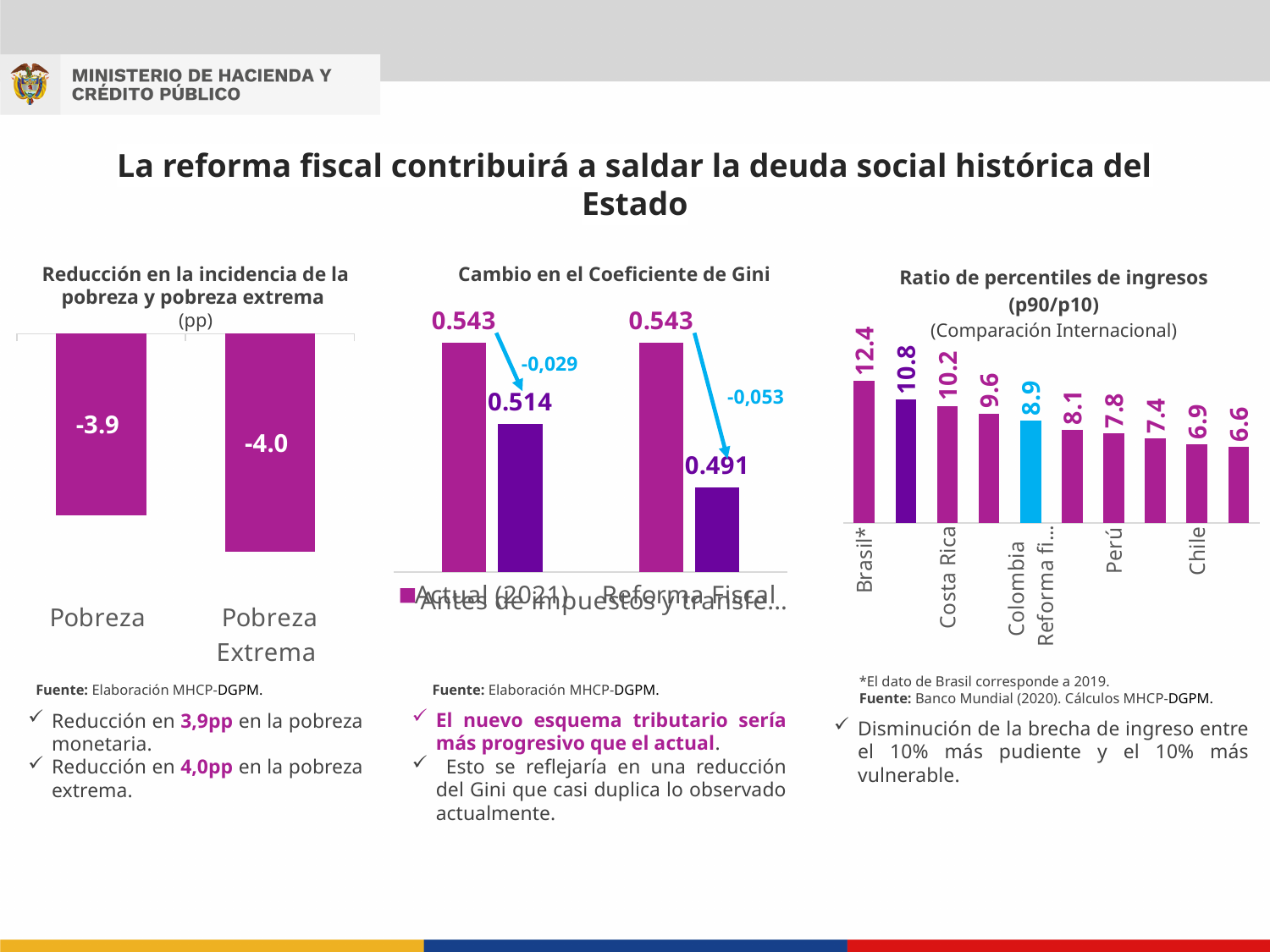
In the chart 'Cambio en el Coeficiente de Gini', what is the lower Gini value shown for Reforma Fiscal? 0.491 In the chart 'Ratio de percentiles de ingresos (p90/p10)', which labelled country has the highest value? Brasil* In the chart 'Reducción en la incidencia de la pobreza y pobreza extrema', what is the value for Pobreza Extrema? -4.0 In the chart 'Reducción en la incidencia de la pobreza y pobreza extrema', what is the value for Pobreza? -3.9 In the chart 'Cambio en el Coeficiente de Gini', what change is annotated for the Reforma Fiscal group? -0,053 In the chart 'Reducción en la incidencia de la pobreza y pobreza extrema', how many categories are shown? 2 In the chart 'Cambio en el Coeficiente de Gini', what is the lower Gini value shown for Actual (2021)? 0.514 In the chart 'Cambio en el Coeficiente de Gini', what change is annotated for the Actual (2021) group? -0,029 What kind of chart is 'Cambio en el Coeficiente de Gini'? bar chart In the chart 'Ratio de percentiles de ingresos (p90/p10)', what is the difference between the values for Costa Rica and Perú? 2.4 In the chart 'Ratio de percentiles de ingresos (p90/p10)', what is the value for Chile? 6.9 In the chart 'Ratio de percentiles de ingresos (p90/p10)', what is the value for Brasil*? 12.4